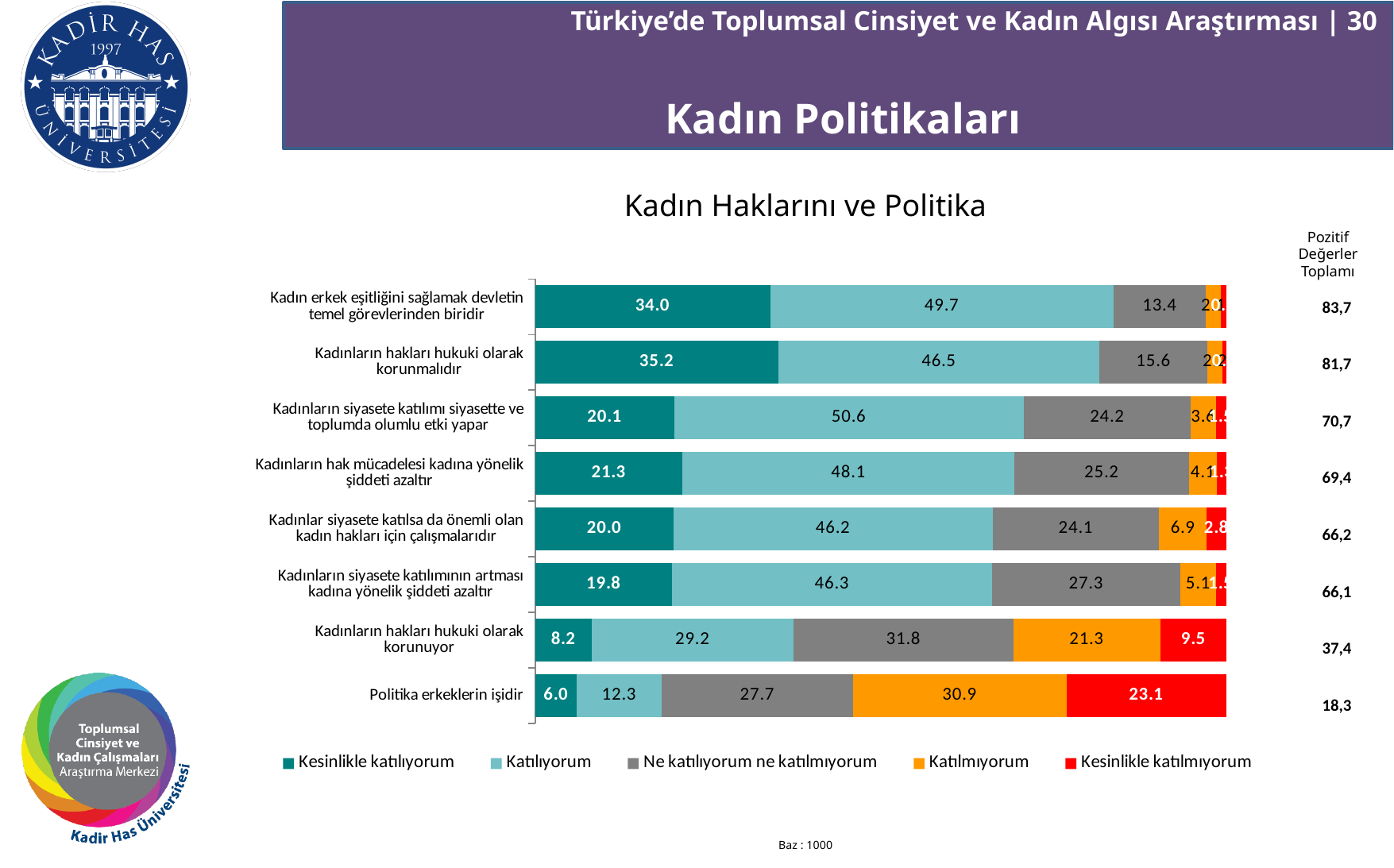
What is the difference between the 'Ne katılıyorum ne katılmıyorum' values for 'Kadınların hakları hukuki olarak korunuyor' and 'Politika erkeklerin işidir'? 4.1 What is the 'Katılıyorum' value for 'Kadınların siyasete katılımı siyasette ve toplumda olumlu etki yapar'? 50.6 Which statement has the highest 'Kesinlikle katılıyorum' value? Kadınların hakları hukuki olarak korunmalıdır What is the 'Pozitif Değerler Toplamı' shown for 'Kadınlar siyasete katılsa da önemli olan kadın hakları için çalışmalarıdır'? 66,2 What kind of chart is shown on the slide? Stacked bar chart Which is larger: the 'Katılıyorum' value for 'Kadın erkek eşitliğini sağlamak devletin temel görevlerinden biridir' or for 'Kadınların hak mücadelesi kadına yönelik şiddeti azaltır'? Kadın erkek eşitliğini sağlamak devletin temel görevlerinden biridir Which statement has the lowest 'Pozitif Değerler Toplamı'? Politika erkeklerin işidir How many statements (categories) are plotted in the chart? 8 What is the 'Kesinlikle katılıyorum' value for 'Kadınların hakları hukuki olarak korunmalıdır'? 35.2 How many series does the legend list? 5 What is the 'Katılmıyorum' value for 'Kadınların hakları hukuki olarak korunuyor'? 21.3 What is the 'Kesinlikle katılmıyorum' value for 'Politika erkeklerin işidir'? 23.1